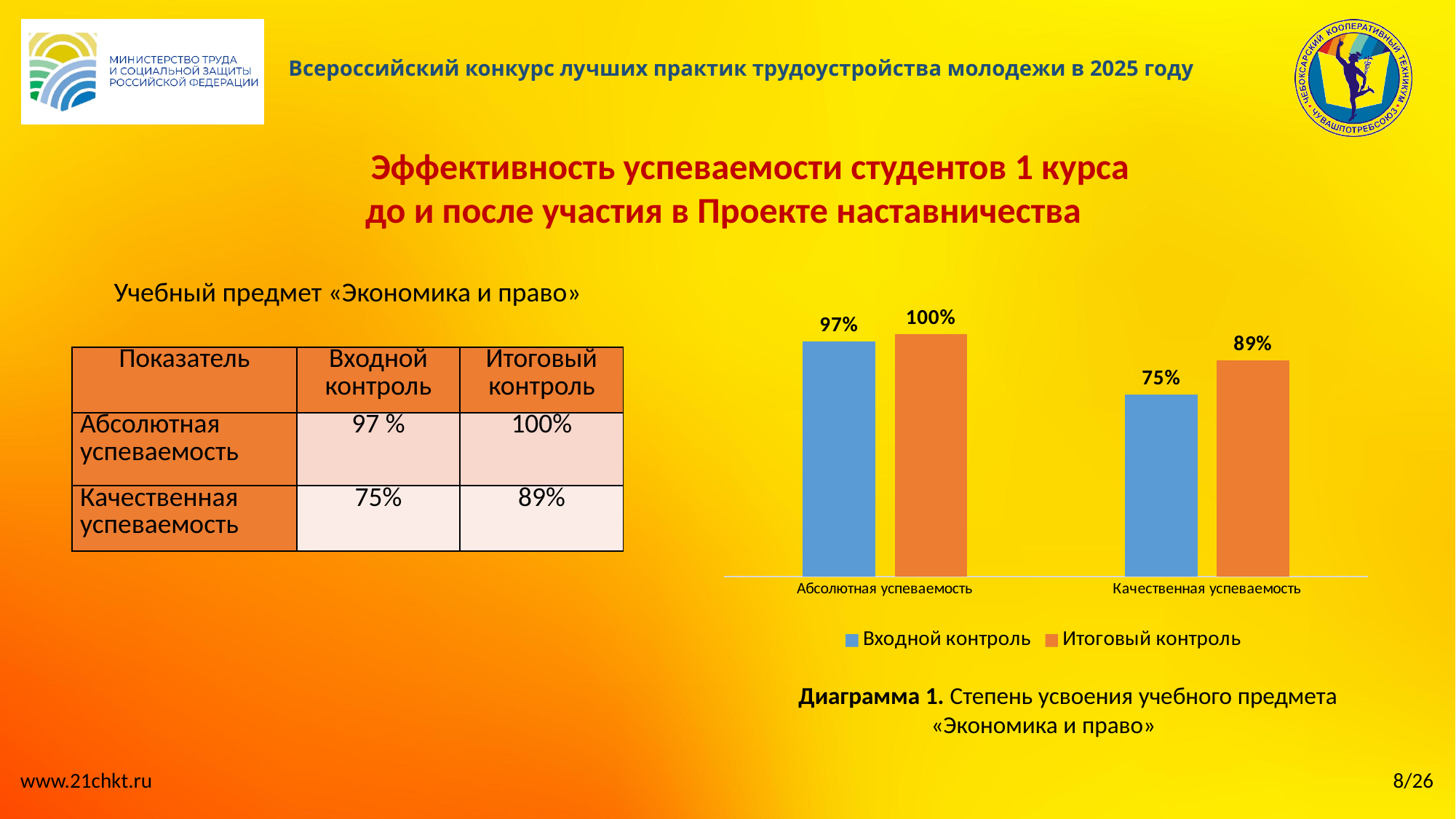
What is the value of Входной контроль for Качественная успеваемость in the chart? 75% Which bar in the chart has the highest value? Итоговый контроль for Абсолютная успеваемость Which is larger for Качественная успеваемость: Входной контроль or Итоговый контроль? Итоговый контроль What is the value of Входной контроль for Абсолютная успеваемость in the chart? 97% What type of chart is shown on the slide? Bar chart What is the value of Итоговый контроль for Абсолютная успеваемость in the chart? 100% How many categories are shown on the x axis of the chart? 2 What is the value of Итоговый контроль for Качественная успеваемость in the chart? 89% How many series does the chart legend list? 2 What is the difference between Итоговый контроль and Входной контроль for Качественная успеваемость? 14% What is the difference between Итоговый контроль and Входной контроль for Абсолютная успеваемость? 3% Which bar in the chart has the lowest value? Входной контроль for Качественная успеваемость